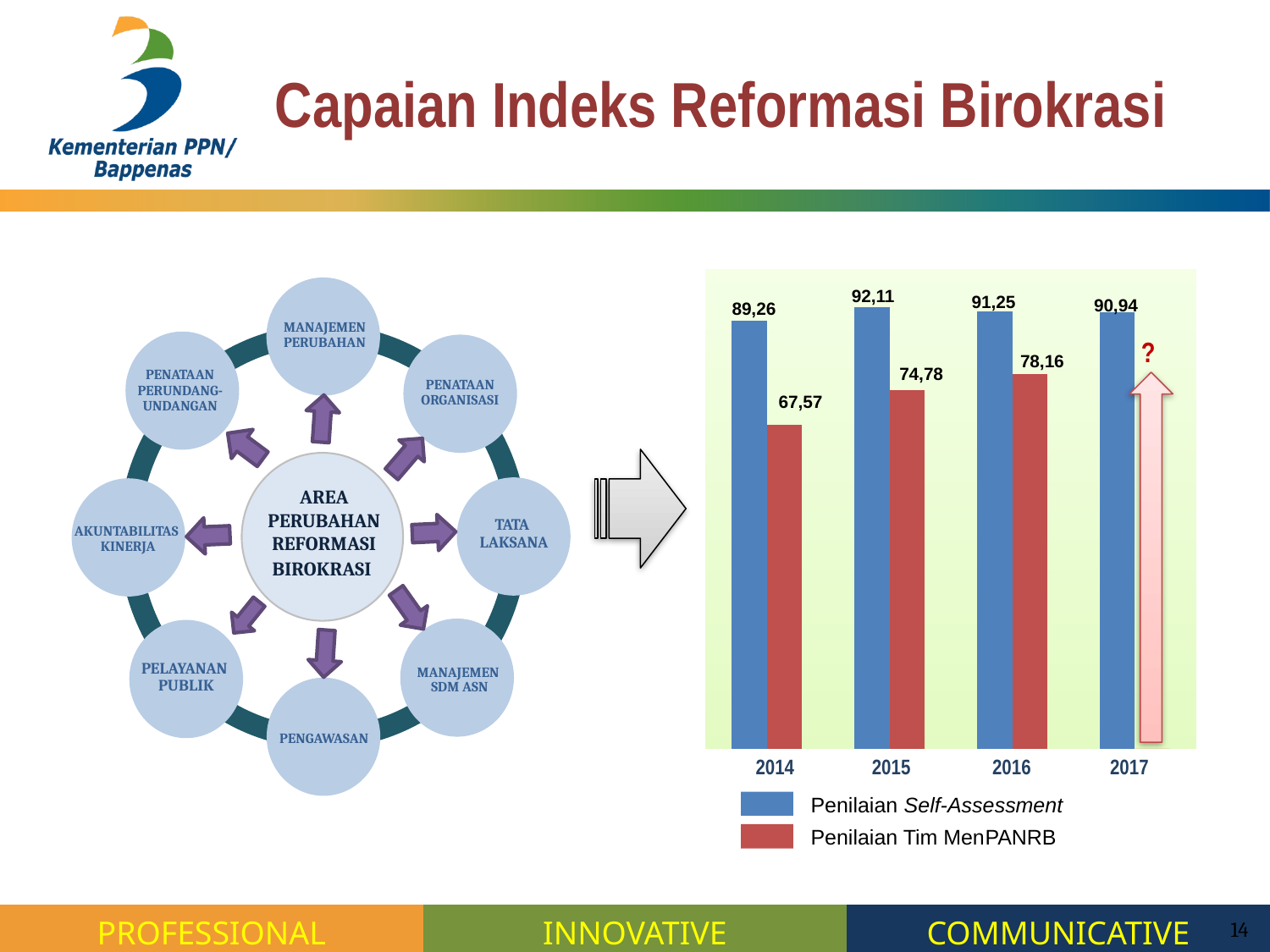
What kind of chart is shown on the right side of the slide? Bar chart How many series does the legend of the bar chart list? 2 How many years are shown on the x axis of the bar chart? 4 In which year is the Penilaian Tim MenPANRB value lowest? 2014 Does the Penilaian Tim MenPANRB value rise or fall from 2014 to 2016? Rise Which is larger in 2015: the Penilaian Self-Assessment value or the Penilaian Tim MenPANRB value? Penilaian Self-Assessment What is the Penilaian Self-Assessment value for 2015? 92,11 What is the difference between the Penilaian Self-Assessment and Penilaian Tim MenPANRB values in 2016? 13,09 What is the difference between the Penilaian Self-Assessment and Penilaian Tim MenPANRB values in 2014? 21,69 What is the Penilaian Tim MenPANRB value for 2014? 67,57 What is the Penilaian Tim MenPANRB value for 2016? 78,16 In which year is the Penilaian Self-Assessment value highest? 2015